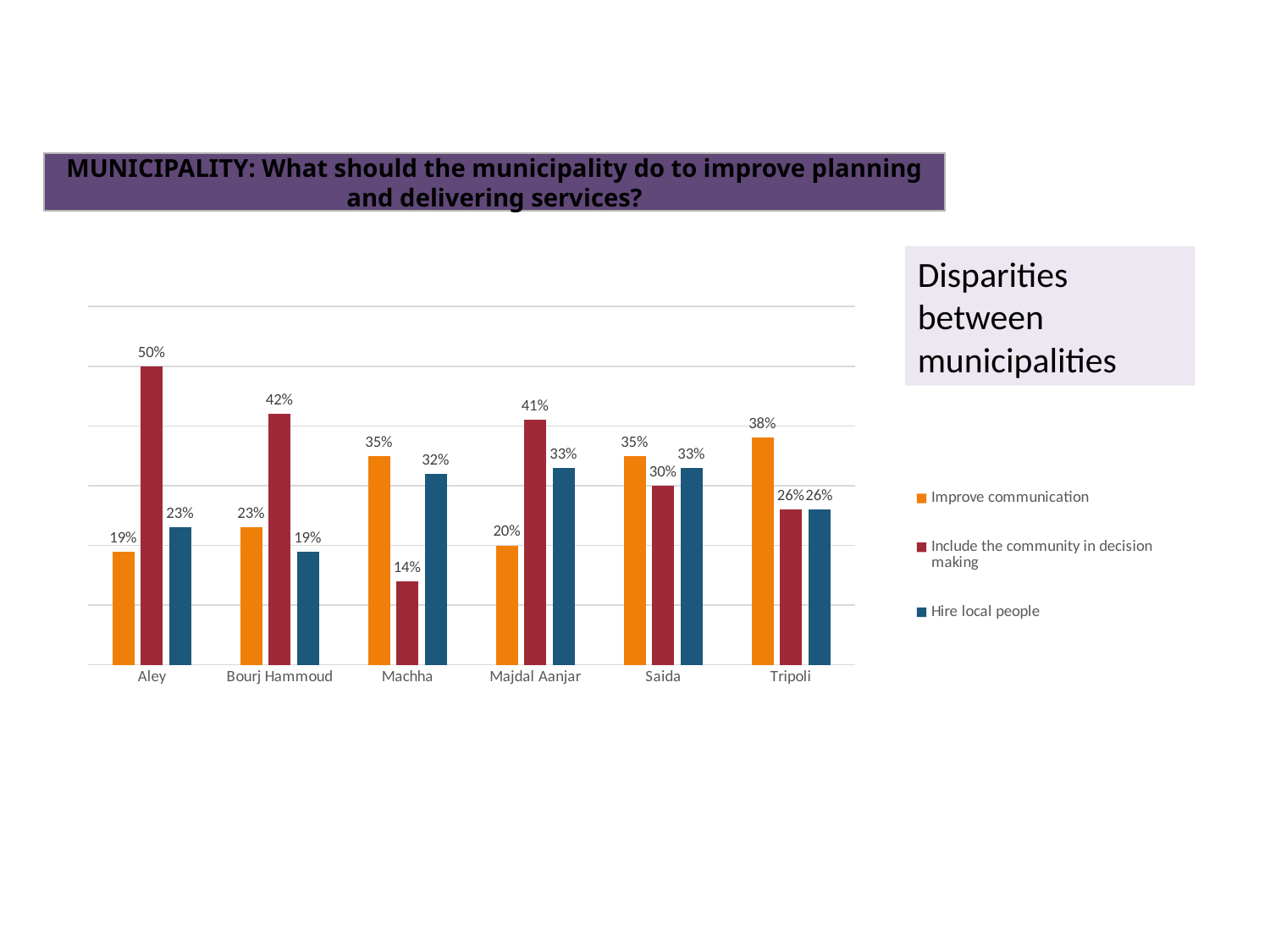
What is the value for 'Improve communication' in Tripoli? 38% Which municipality has the highest value for 'Include the community in decision making'? Aley How many series does the legend list? 3 What is the value for 'Hire local people' in Machha? 32% Which municipality has the lowest value for 'Improve communication'? Aley What is the value for 'Include the community in decision making' in Aley? 50% How many municipalities are shown on the x axis? 6 In Saida, which is larger: 'Improve communication' or 'Include the community in decision making'? Improve communication What colour represents 'Hire local people' in the chart? Blue What kind of chart is shown on the slide? Bar chart What is the difference between 'Include the community in decision making' and 'Improve communication' in Bourj Hammoud? 19% Which municipality has the lowest value for 'Include the community in decision making'? Machha